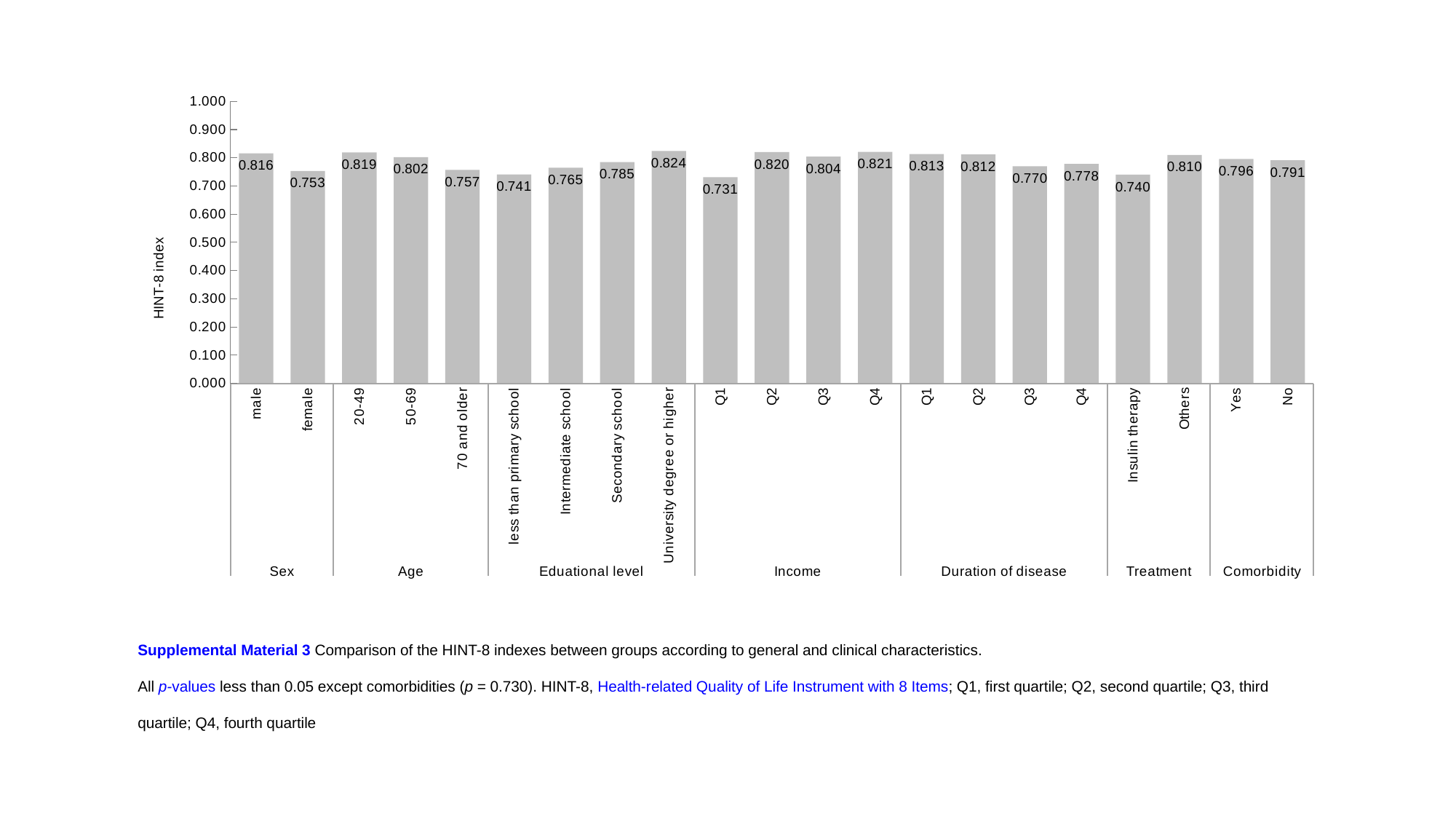
Which category has the lowest HINT-8 index on the chart? Income Q1 Do the HINT-8 index values rise or fall across the Educational level categories from less than primary school to University degree or higher? rise What is the HINT-8 index for the Insulin therapy group? 0.740 What kind of chart is shown on the slide? bar chart What is the difference between the HINT-8 index for males and females? 0.063 Which has a higher HINT-8 index, Income Q1 or Income Q2? Income Q2 What is the HINT-8 index for females? 0.753 Which category has the highest HINT-8 index on the chart? University degree or higher What is the HINT-8 index for the 70 and older age group? 0.757 How many bars are plotted on the chart? 21 Is the HINT-8 index for Secondary school greater or less than 0.700? greater What is the difference between the HINT-8 index for Others and Insulin therapy in the Treatment group? 0.070